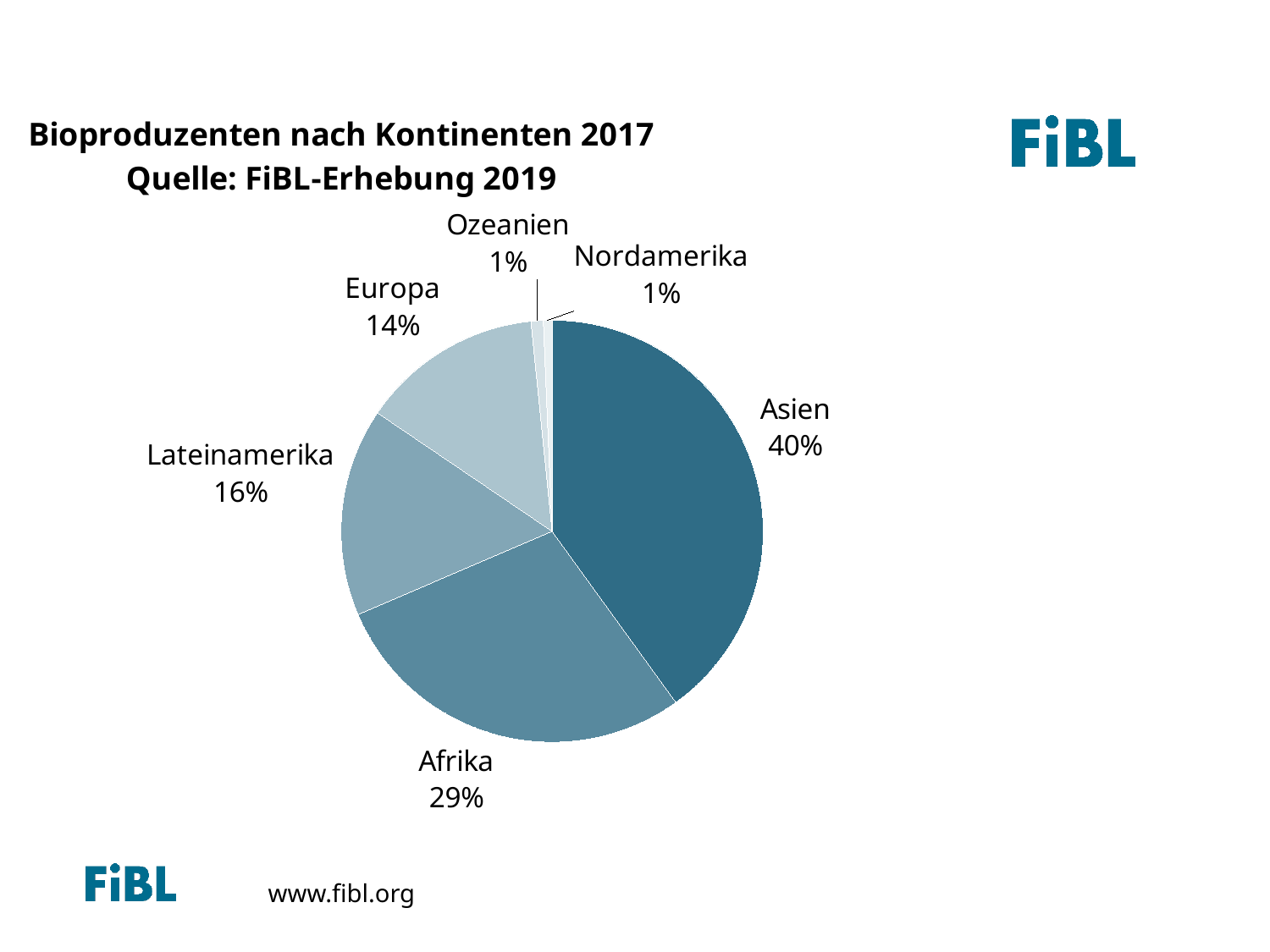
What share of the pie does Afrika have? 29% What share of the pie does Europa have? 14% What share of the pie does Lateinamerika have? 16% What is the difference in percentage points between the shares of Asien and Afrika? 11 How many slices does the pie chart have? 6 What kind of chart is shown on the slide? Pie chart Which continent has the largest share of the pie? Asien Which has a larger share, Afrika or Lateinamerika? Afrika What is the difference in percentage points between the shares of Lateinamerika and Europa? 2 What is the title of the chart? Bioproduzenten nach Kontinenten 2017